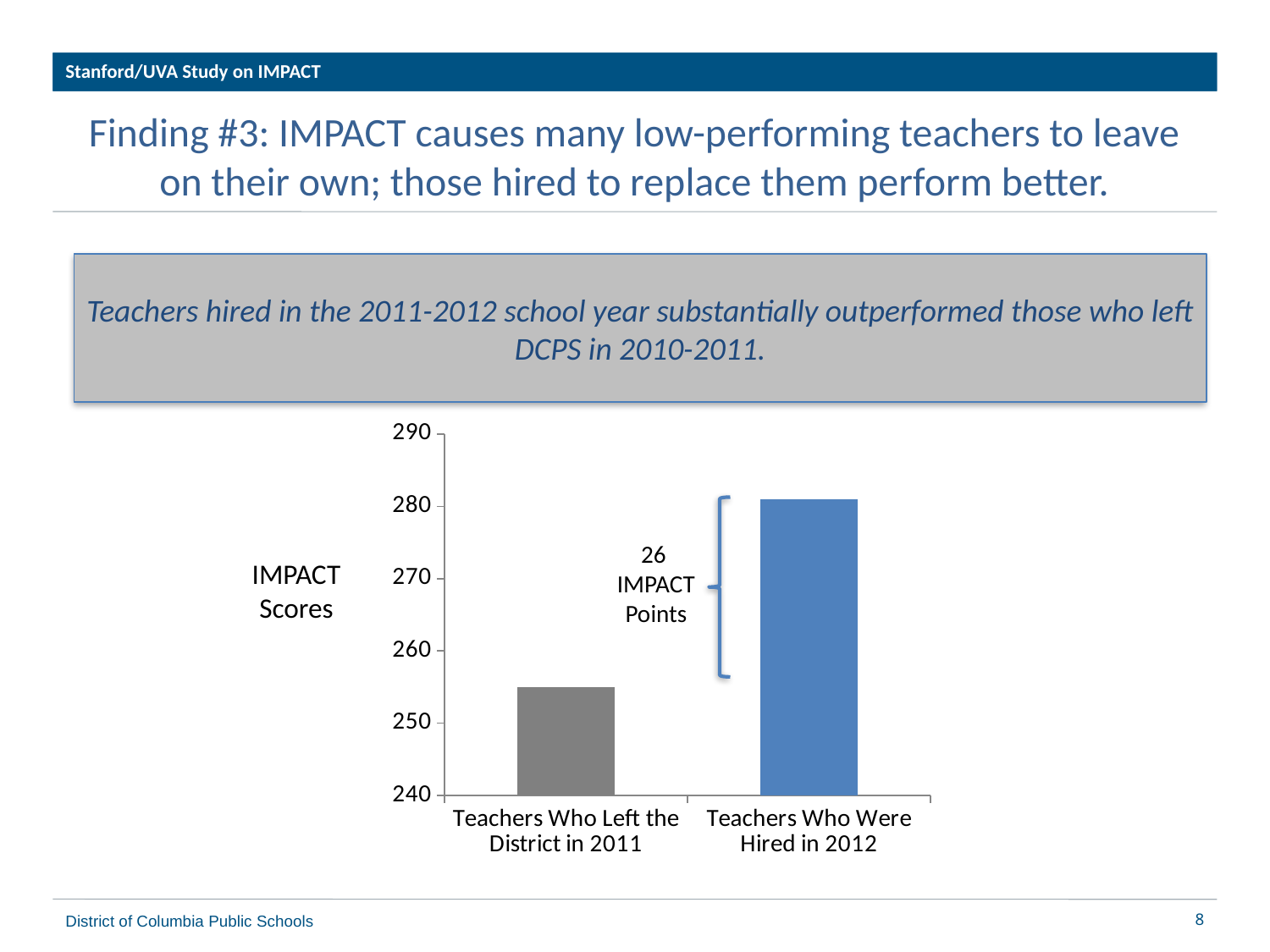
How many categories are plotted in the chart? 2 What colour is the bar for Teachers Who Were Hired in 2012? blue What is the label on the vertical axis of the chart? IMPACT Scores Is the value for Teachers Who Left the District in 2011 greater or less than 260? less Which category has the lower IMPACT score? Teachers Who Left the District in 2011 Is the value for Teachers Who Were Hired in 2012 greater or less than 270? greater Is the value for Teachers Who Left the District in 2011 greater or less than 250? greater By how many IMPACT points do Teachers Who Were Hired in 2012 exceed Teachers Who Left the District in 2011, according to the annotation on the chart? 26 What kind of chart is shown on the slide? bar chart Which category has the higher IMPACT score? Teachers Who Were Hired in 2012 Is the IMPACT score for Teachers Who Were Hired in 2012 larger or smaller than that for Teachers Who Left the District in 2011? larger